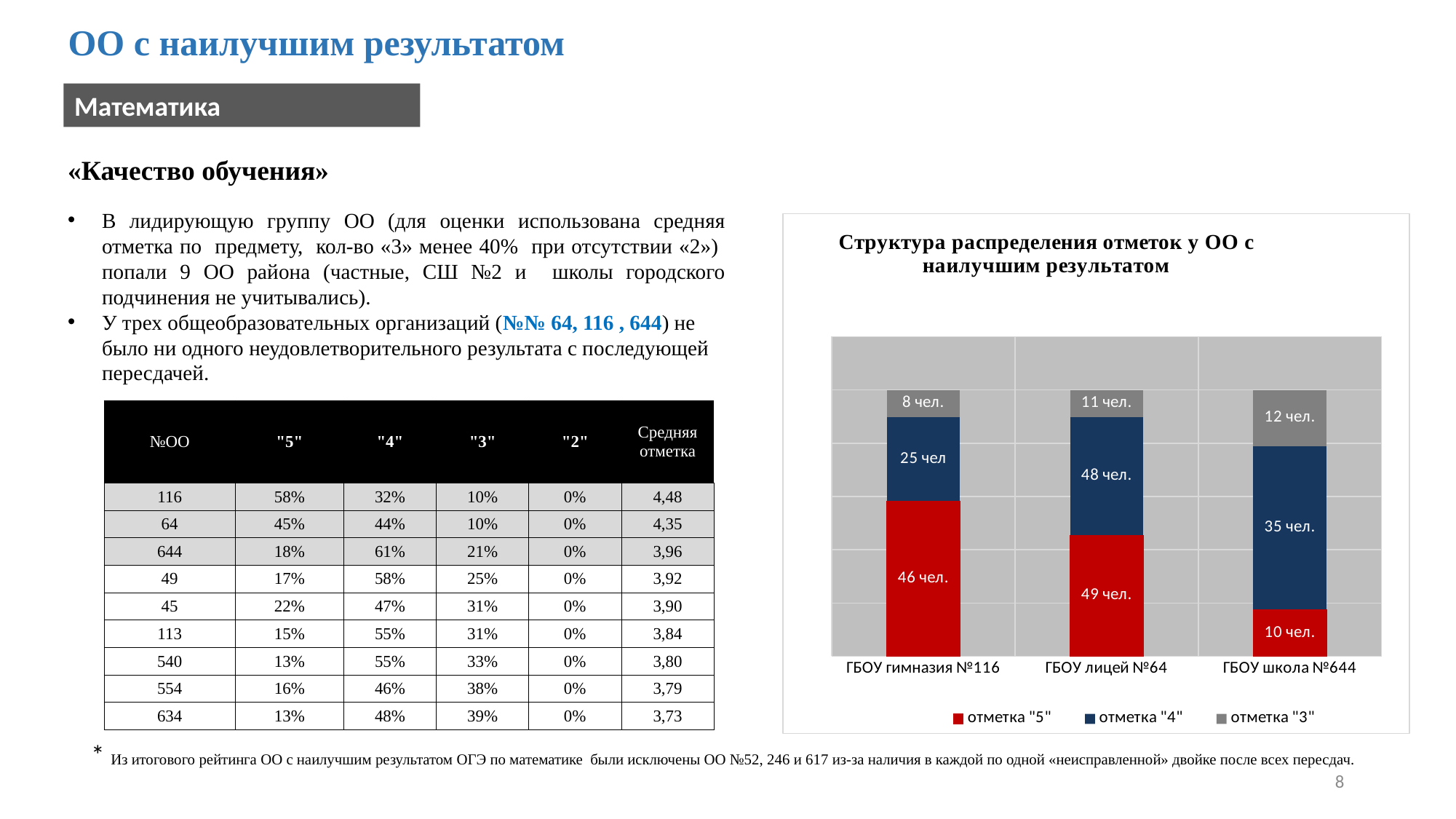
What is the value of отметка "5" for ГБОУ гимназия №116? 46 чел. Which school has the lowest value for отметка "4"? ГБОУ гимназия №116 Which is larger: отметка "3" for ГБОУ лицей №64 or отметка "3" for ГБОУ гимназия №116? ГБОУ лицей №64 What is the value of отметка "3" for ГБОУ школа №644? 12 чел. What is the value of отметка "4" for ГБОУ лицей №64? 48 чел. What is the total number of students in the stacked bar for ГБОУ лицей №64? 108 чел. What is the difference between the отметка "5" values for ГБОУ лицей №64 and ГБОУ школа №644? 39 чел. How many schools (categories) are shown on the x axis of the chart? 3 What is the title of the chart? Структура распределения отметок у ОО с наилучшим результатом How many series does the chart legend list? 3 Which school has the highest value for отметка "5"? ГБОУ лицей №64 What kind of chart is shown on the slide? stacked bar chart